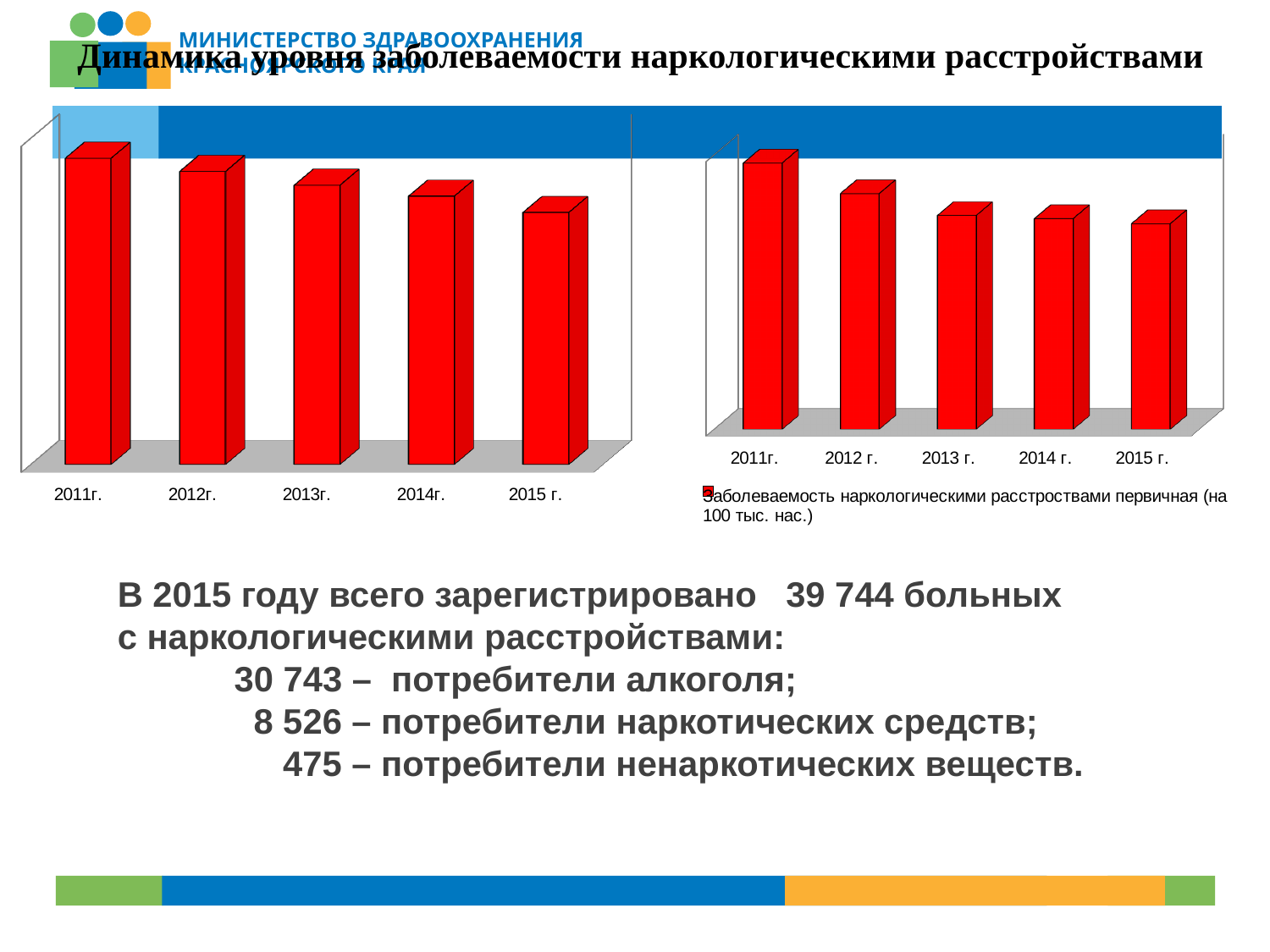
In the right chart, which year has the highest bar? 2011г. In the left chart, how many years are shown on the x axis? 5 What kind of chart is the right chart on the slide? bar chart In the right chart, how many bars are plotted? 5 In the left chart, which year has the lowest bar? 2015 г. What kind of chart is the left chart on the slide? bar chart In the right chart, do the values rise or fall from 2011 to 2015? fall In the left chart, which year has the highest bar? 2011г. How many series does the legend of the right chart list? 1 In the left chart, which is larger, the bar for 2012г. or the bar for 2014г.? 2012г. In the right chart, which year has the lowest bar? 2015 г. In the left chart, do the values rise or fall from 2011 to 2015? fall